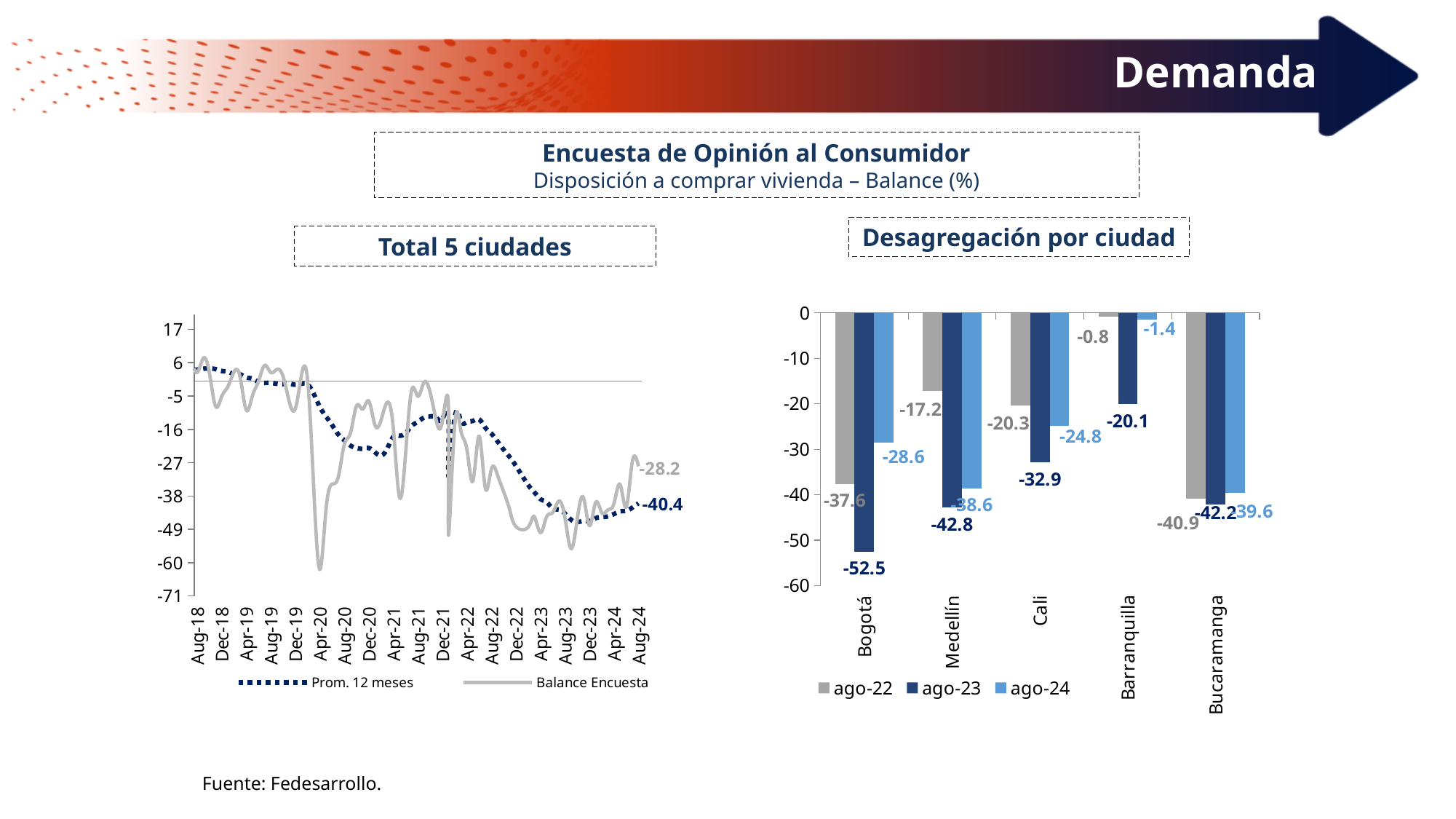
In the 'Desagregación por ciudad' chart, what is the ago-23 value for Bogotá? -52.5 In the 'Desagregación por ciudad' chart, which is larger for Cali: the ago-22 value or the ago-24 value? ago-22 In the 'Desagregación por ciudad' chart, what is the difference between the ago-23 and ago-24 values for Bogotá? 23.9 In the 'Desagregación por ciudad' chart, what is the ago-22 value for Barranquilla? -0.8 In the 'Desagregación por ciudad' chart, what is the ago-24 value for Medellín? -38.6 In the 'Total 5 ciudades' chart, what is the last labelled value of the Prom. 12 meses series? -40.4 What kind of chart is the 'Total 5 ciudades' chart? Line chart In the 'Total 5 ciudades' chart, what is the last labelled value of the Balance Encuesta series? -28.2 In the 'Desagregación por ciudad' chart, which city has the highest ago-24 value? Barranquilla How many cities are shown in the 'Desagregación por ciudad' chart? 5 How many series does the legend of the 'Desagregación por ciudad' chart list? 3 In the 'Desagregación por ciudad' chart, which city has the lowest ago-23 value? Bogotá